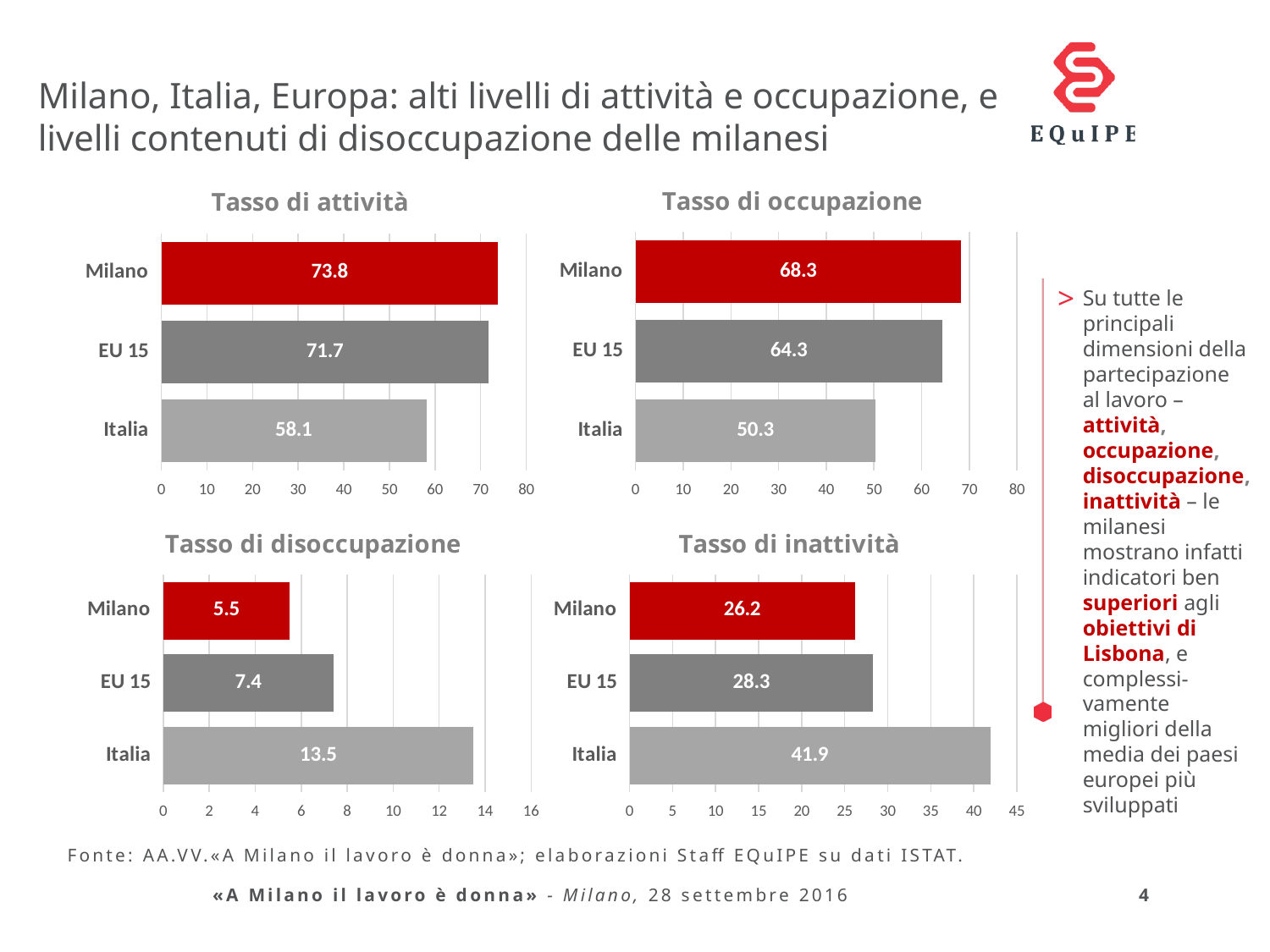
In the 'Tasso di disoccupazione' chart, what is the value for EU 15? 7.4 In the 'Tasso di disoccupazione' chart, which category has the lowest value? Milano In the 'Tasso di occupazione' chart, what is the value for Italia? 50.3 In the 'Tasso di attività' chart, what is the value for Milano? 73.8 In the 'Tasso di inattività' chart, which category has the highest value? Italia In the 'Tasso di occupazione' chart, which is larger, the value for Milano or the value for EU 15? Milano In the 'Tasso di attività' chart, what is the difference between the values for Milano and Italia? 15.7 What kind of chart is the 'Tasso di occupazione' chart? bar chart How many charts are shown on the slide? 4 How many categories are shown in the 'Tasso di disoccupazione' chart? 3 In the 'Tasso di inattività' chart, is the value for Italia greater or less than 40? greater In the 'Tasso di inattività' chart, what is the difference between the values for Italia and Milano? 15.7